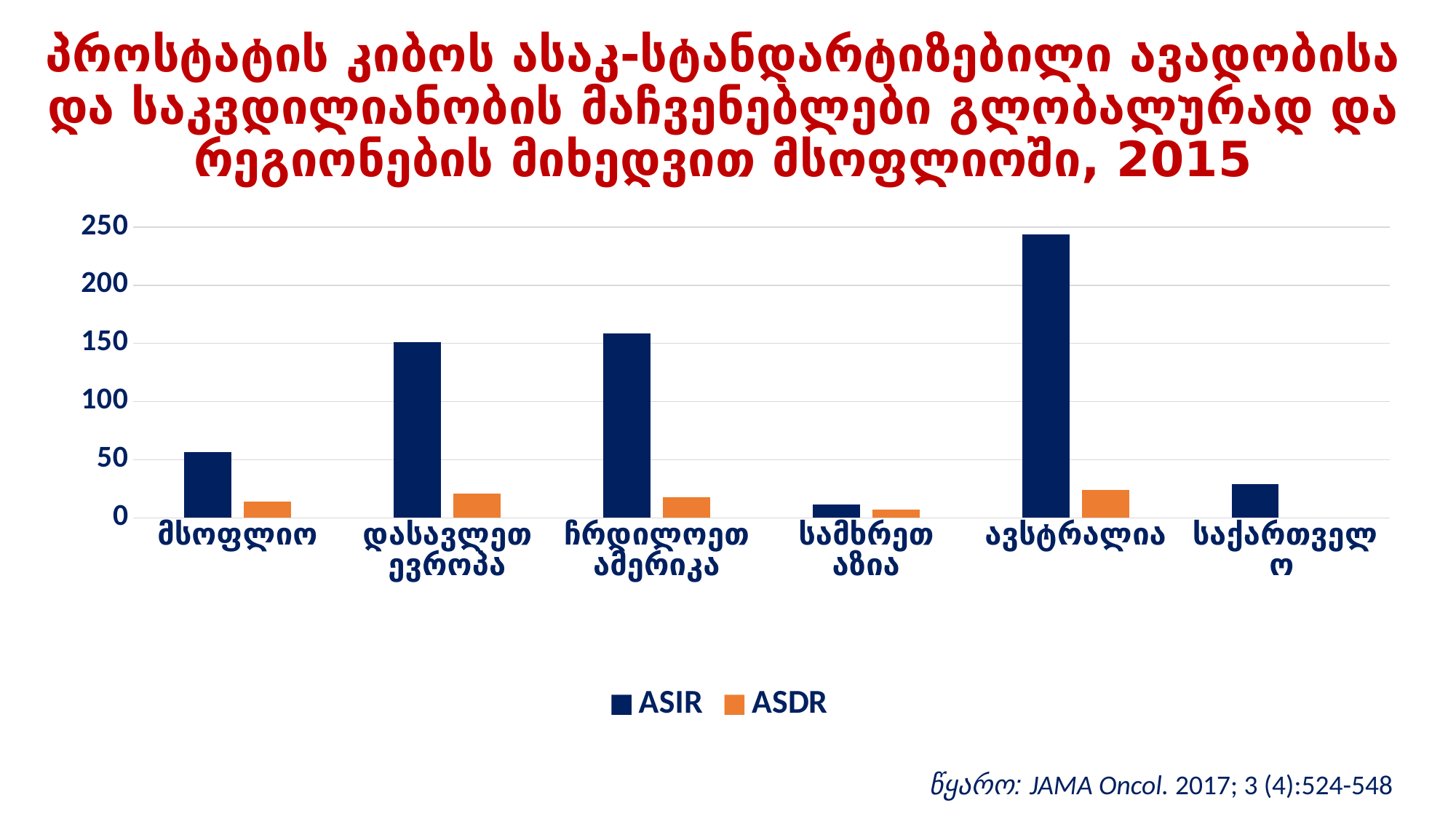
Which category has the lowest ASIR value? სამხრეთ აზია What kind of chart is shown on the slide? bar chart Which is larger, the ASIR value for მსოფლიო or the ASIR value for საქართველო? მსოფლიო How many categories are shown on the x axis? 6 Which colour represents the ASDR series in the legend? orange Is the ASDR value for ჩრდილოეთ ამერიკა greater or less than 50? less Is the ASIR value for დასავლეთ ევროპა greater or less than 100? greater Which category has the highest ASIR value? ავსტრალია Which is larger for ავსტრალია, the ASIR value or the ASDR value? ASIR Is the ASIR value for მსოფლიო greater or less than 100? less How many series does the legend list? 2